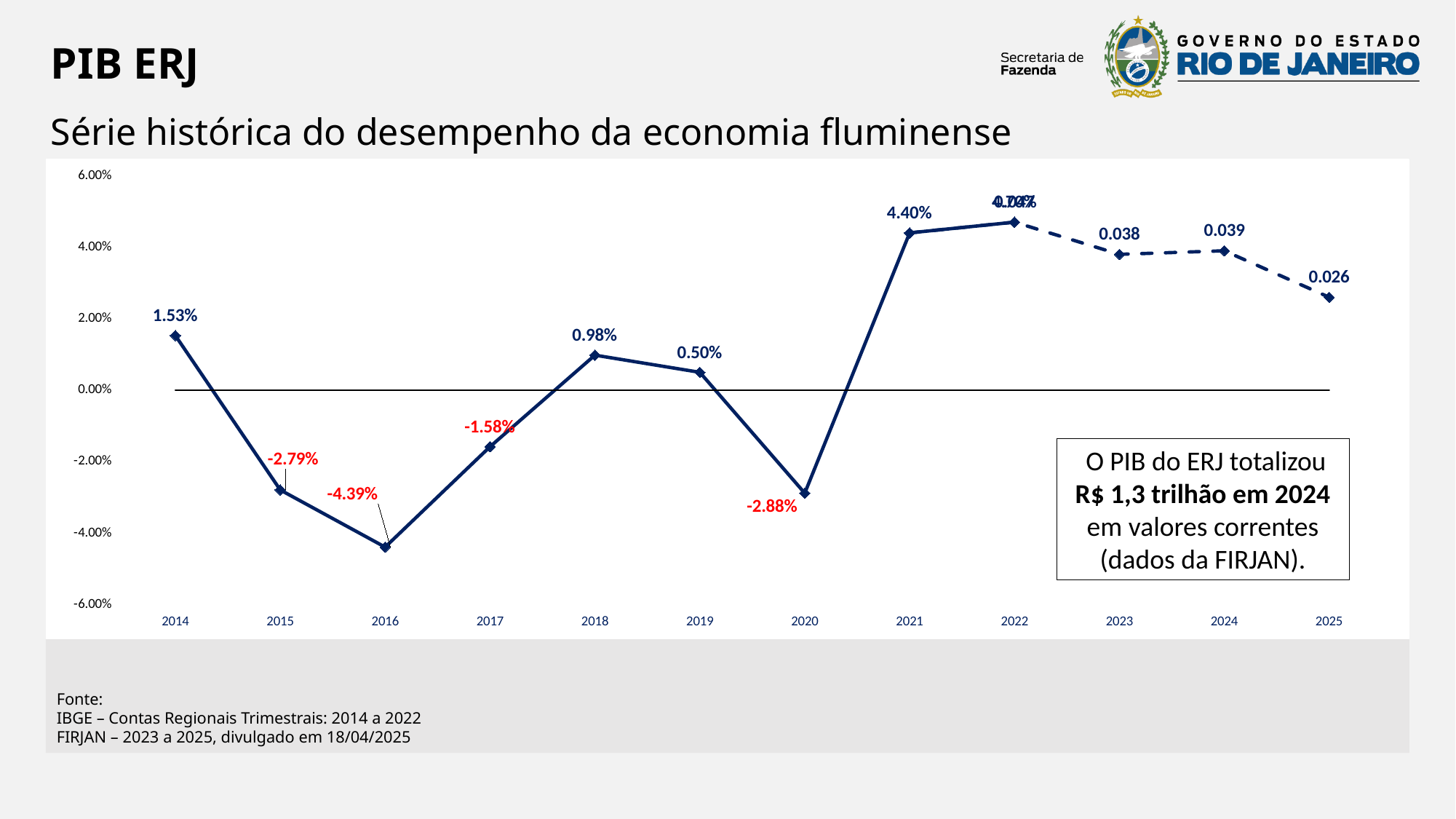
What kind of chart is shown on the slide? Line chart Do the values rise or fall from 2023 to 2025? Fall What is the value for 2025? 0.026 Is the value for 2022 greater or less than 4.00%? greater How many years are plotted on the x axis? 12 What is the value for 2014? 1.53% What is the value for 2016? -4.39% Which is larger, the value for 2018 or the value for 2019? 2018 What is the value for 2021? 4.40% Which year has the lowest value? 2016 In what colour are the data labels for the negative values shown? Red What is the difference between the values for 2021 and 2014? 2.87 percentage points